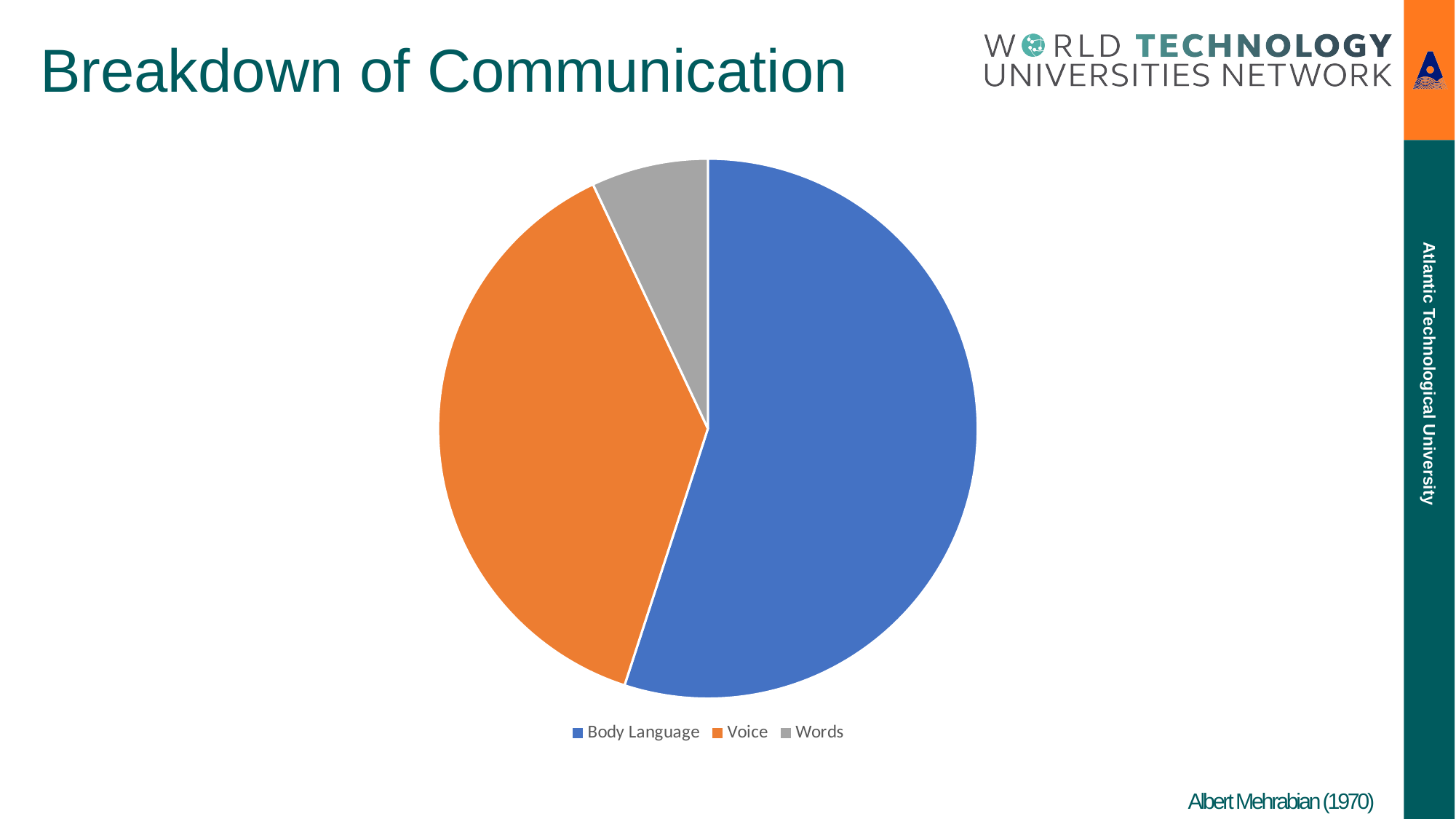
How many slices does the pie chart have? 3 Which slice is larger, Voice or Words? Voice What is the title of the slide containing the pie chart? Breakdown of Communication Which slice is larger, Body Language or Voice? Body Language Which category has the largest slice of the pie chart? Body Language Which category has the smallest slice of the pie chart? Words What colour is the Voice slice in the pie chart? orange What kind of chart is shown on the slide? pie chart How many entries does the legend of the pie chart list? 3